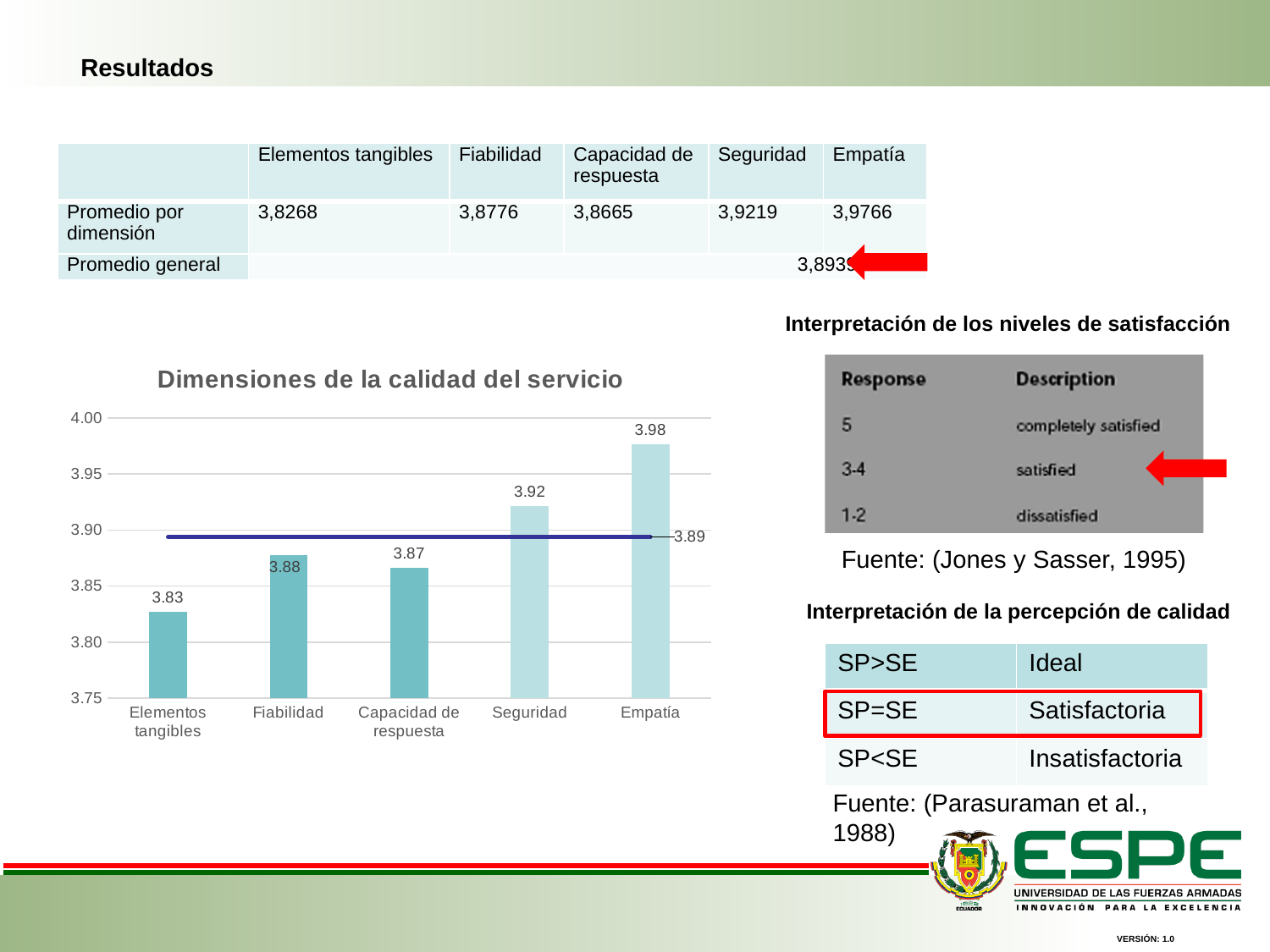
What value is labelled on the horizontal line drawn across the chart? 3.89 What is the difference between the values for Empatía and Elementos tangibles? 0.15 What is the value for Empatía in the chart? 3.98 How many categories are shown on the x axis of the chart? 5 Is the value for Elementos tangibles greater or less than 3.85? less What is the title of the chart on the slide? Dimensiones de la calidad del servicio Which category has the highest value in the chart? Empatía Which is larger, the value for Seguridad or the value for Fiabilidad? Seguridad What kind of chart is "Dimensiones de la calidad del servicio"? combination bar and line chart What is the value for Elementos tangibles in the chart? 3.83 What is the value for Seguridad in the chart? 3.92 Which category has the lowest value in the chart? Elementos tangibles